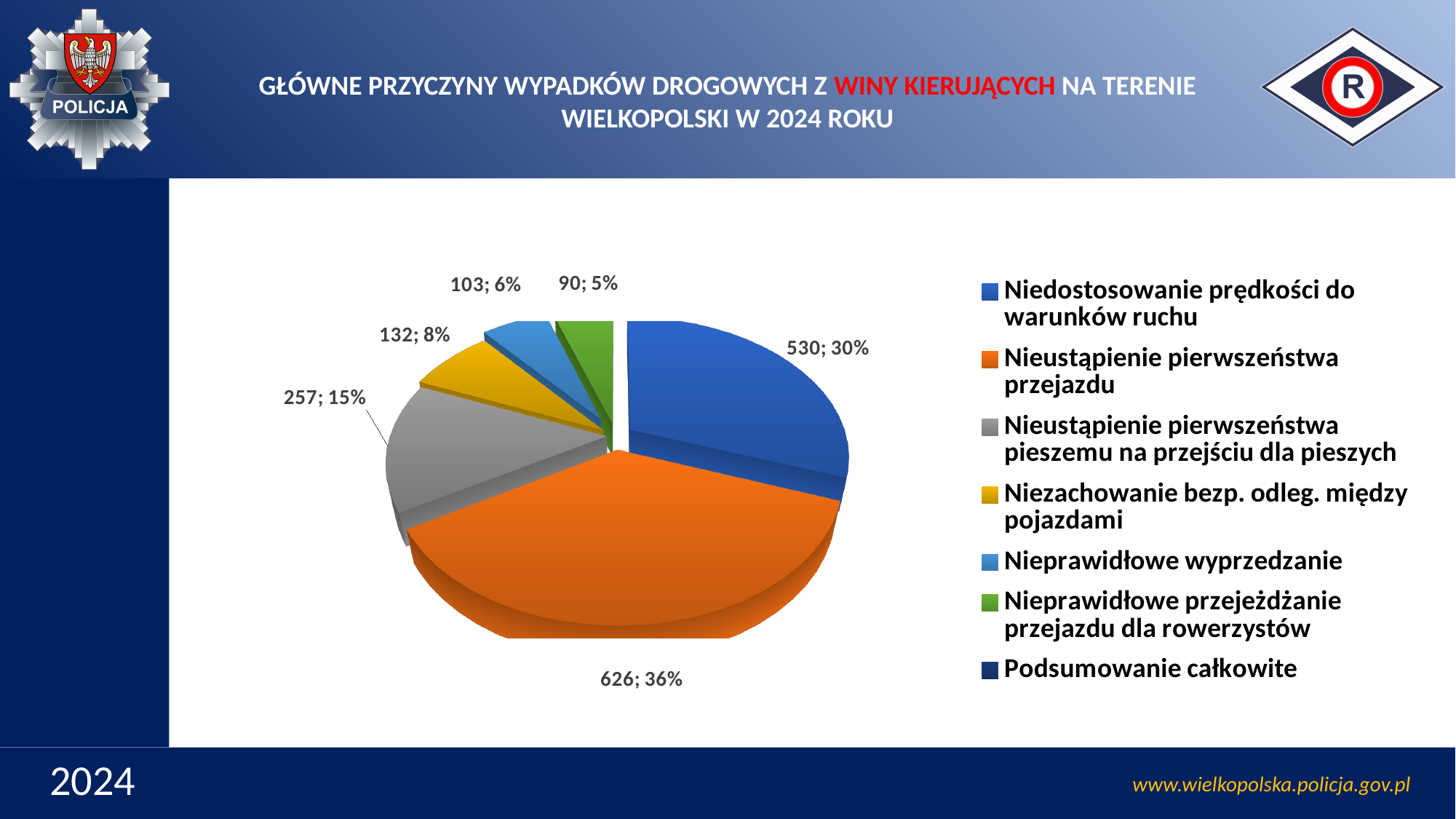
What value is shown for "Niedostosowanie prędkości do warunków ruchu"? 530; 30% Which category has the largest slice of the pie? Nieustąpienie pierwszeństwa przejazdu How many entries does the legend list? 7 How many slices are visible in the pie chart? 6 Which category has the smallest slice of the pie? Nieprawidłowe przejeżdżanie przejazdu dla rowerzystów What is the difference between the number of accidents for "Nieustąpienie pierwszeństwa przejazdu" and "Niedostosowanie prędkości do warunków ruchu"? 96 What value is shown for "Nieustąpienie pierwszeństwa przejazdu"? 626; 36% What value is shown for "Nieprawidłowe wyprzedzanie"? 103; 6% What share of the pie does "Niezachowanie bezp. odleg. między pojazdami" represent? 8% Which is larger: the value for "Niezachowanie bezp. odleg. między pojazdami" or for "Nieprawidłowe wyprzedzanie"? Niezachowanie bezp. odleg. między pojazdami What value is shown for "Nieustąpienie pierwszeństwa pieszemu na przejściu dla pieszych"? 257; 15% What type of chart is shown on the slide? pie chart